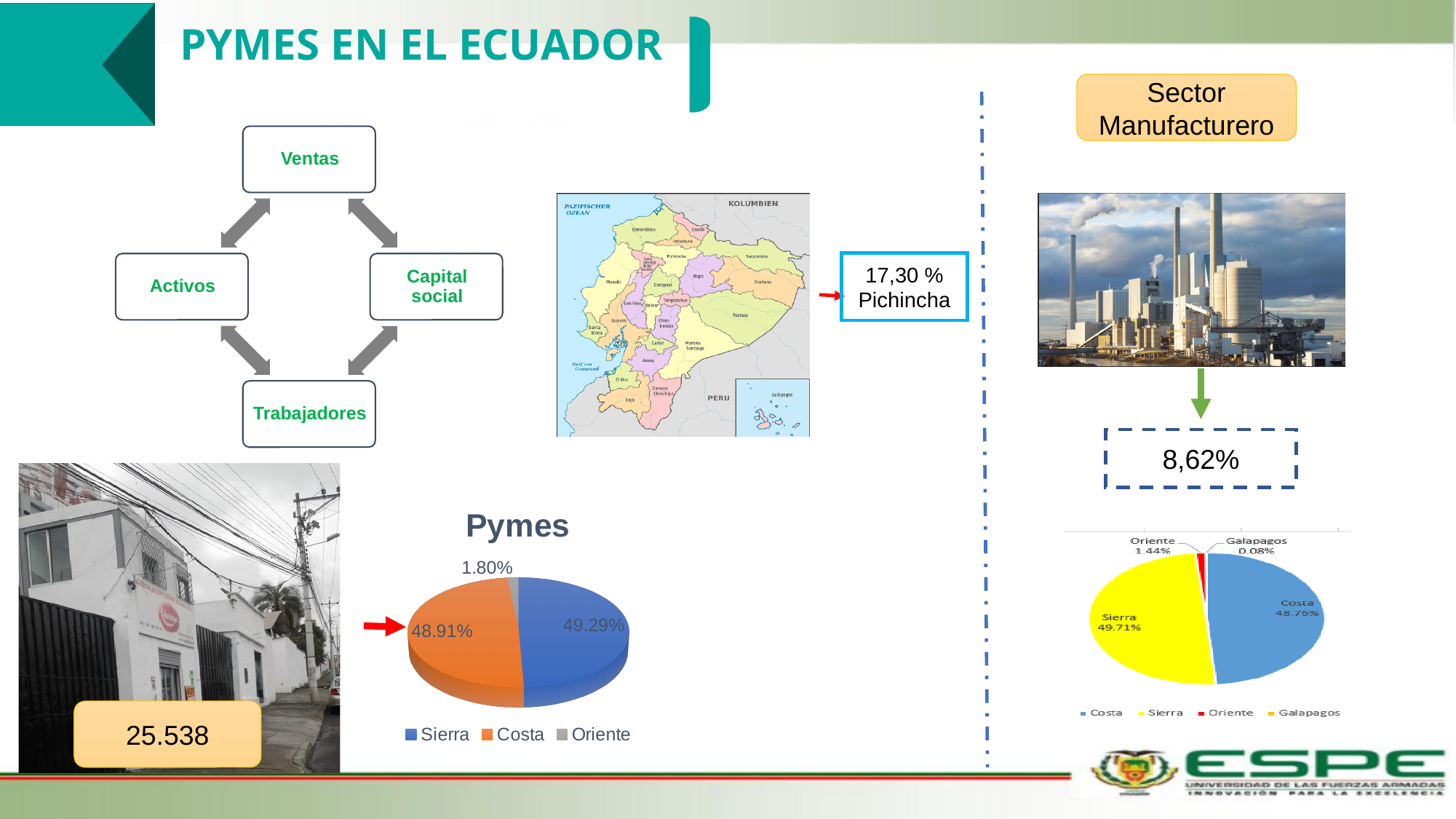
In the 'Pymes' pie chart, how many categories does the legend list? 3 What kind of chart is the 'Pymes' chart? Pie chart In the pie chart on the bottom right of the slide, what is the value for Galapagos? 0.08% In the 'Pymes' pie chart, what is the value for Sierra? 49.29% In the 'Pymes' pie chart, what is the difference between the Sierra and Costa values? 0.38% In the pie chart on the bottom right of the slide, how many categories does the legend list? 4 In the pie chart on the bottom right of the slide, what is the value for Sierra? 49.71% In the pie chart on the bottom right of the slide, what is the value for Oriente? 1.44% In the pie chart on the bottom right of the slide, which category has the smallest share? Galapagos In the 'Pymes' pie chart, what is the value for Costa? 48.91% In the 'Pymes' pie chart, which category has the smallest share? Oriente In the 'Pymes' pie chart, what is the value for Oriente? 1.80%